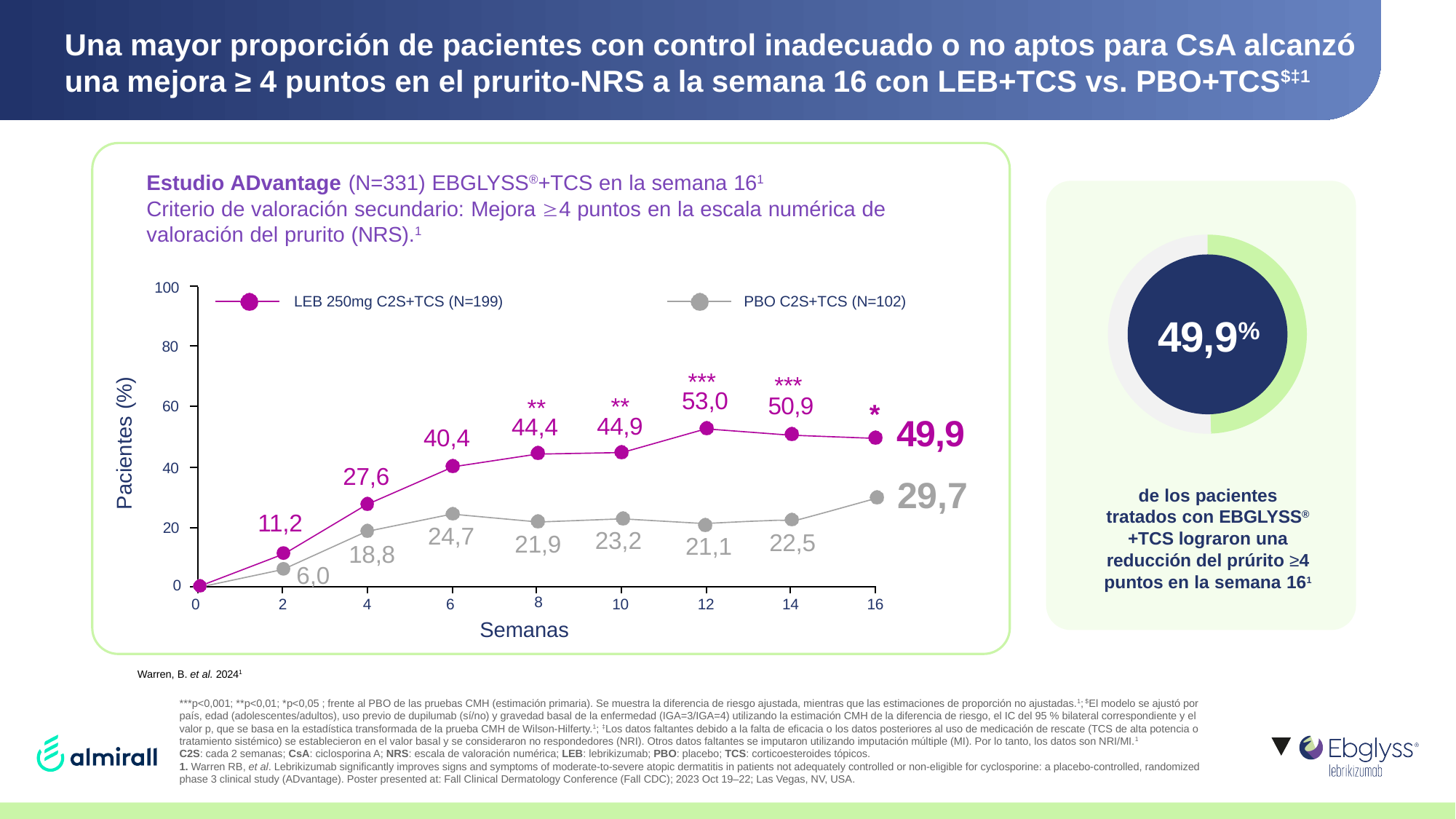
In the line chart, which series has the higher value at week 8? LEB 250mg C2S+TCS In the line chart, what is the value for PBO C2S+TCS at week 2? 6,0 In the line chart, what is the difference between LEB 250mg C2S+TCS and PBO C2S+TCS at week 16? 20,2 In the line chart, at which week does the LEB 250mg C2S+TCS series reach its highest value? 12 In the line chart, what is the value for LEB 250mg C2S+TCS at week 6? 40,4 How many series does the legend of the line chart list? 2 In the line chart, what is the difference between LEB 250mg C2S+TCS and PBO C2S+TCS at week 12? 31,9 In the line chart, what is the value for PBO C2S+TCS at week 16? 29,7 In the line chart, what is the value for LEB 250mg C2S+TCS at week 16? 49,9 In the line chart, at which week does the PBO C2S+TCS series reach its highest value? 16 What percentage is shown in the donut chart on the right of the slide? 49,9% What kind of chart is the chart on the left of the slide? Line chart